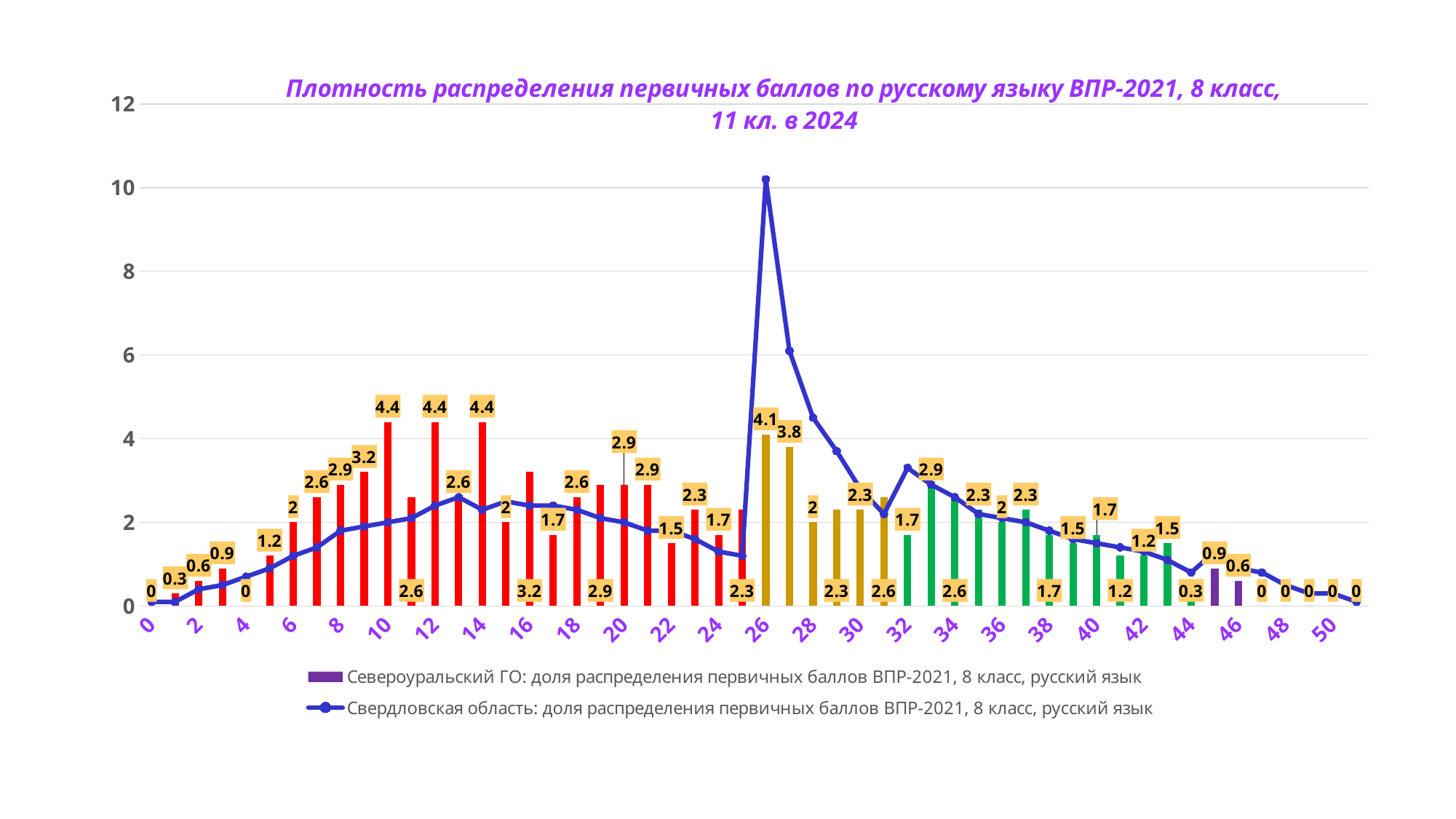
What is the value of the Североуральский ГО bar at score 9? 3.2 What is the difference between the Североуральский ГО bars at scores 26 and 27? 0.3 Is the value of the Свердловская область line at score 28 greater or less than 4? greater Does the Свердловская область line rise or fall from score 44 to score 51? fall What is the value of the Североуральский ГО bar at score 26? 4.1 Is the value of the Свердловская область line at score 26 greater or less than 8? greater How many series does the legend list? 2 What is the highest value reached by the Североуральский ГО bars? 4.4 What kind of chart is shown on the slide? A combined bar and line chart What is the value of the Североуральский ГО bar at score 27? 3.8 Which Североуральский ГО bar is larger, the one at score 10 or the one at score 11? Score 10 What is the value of the Североуральский ГО bar at score 45? 0.9